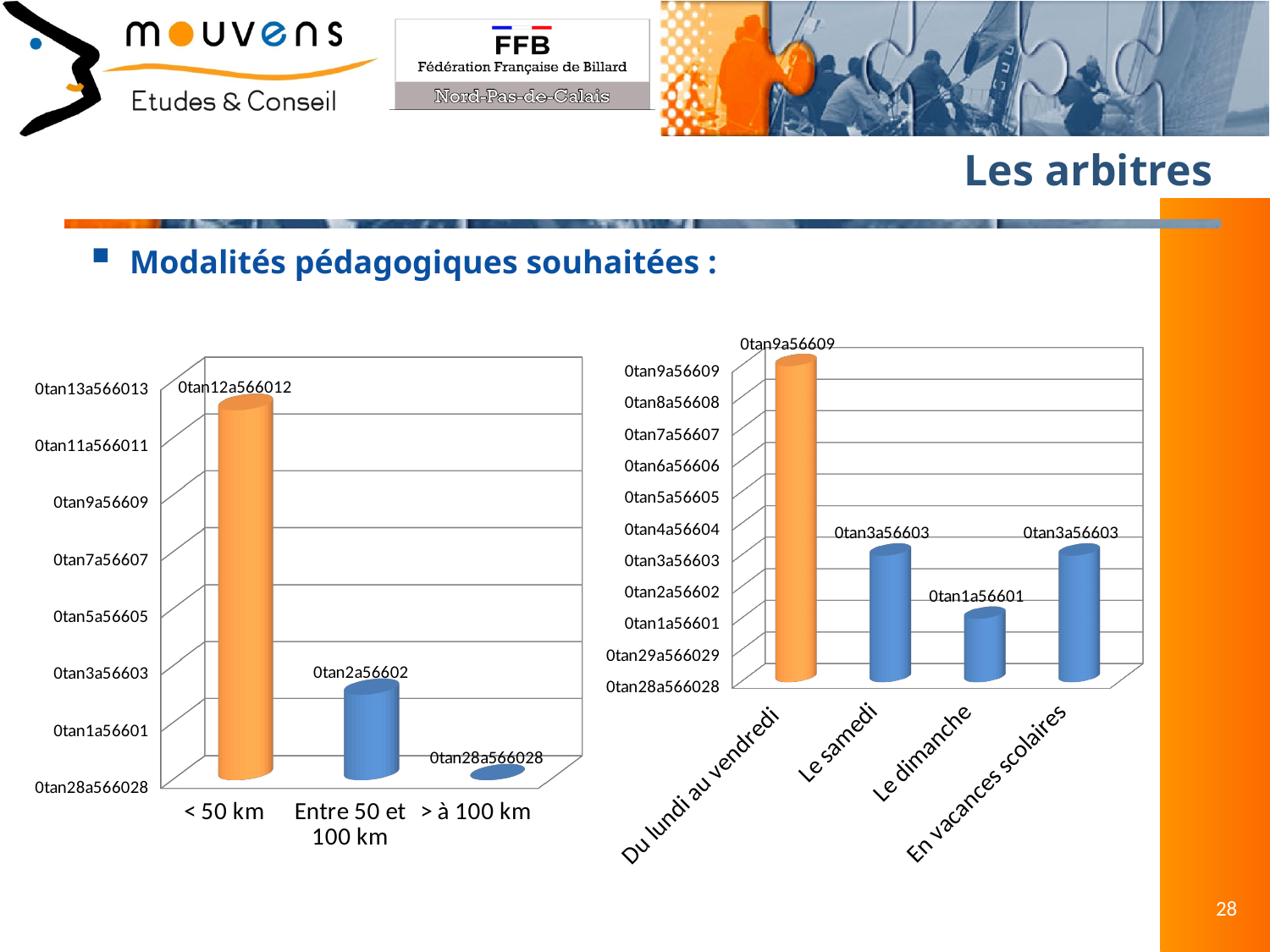
In the left chart, which category has the highest bar? < 50 km How many categories does the right chart show? 4 In the right chart, which is larger: the bar for Le samedi or the bar for Le dimanche? Le samedi In the right chart, what data label is printed above the bar for Le dimanche? 0tan1a56601 In the right chart, which category has the lowest bar? Le dimanche In the right chart, which category has the highest bar? Du lundi au vendredi How many categories does the left chart show? 3 What kind of chart is the left chart on the slide? bar chart In the left chart, which is larger: the bar for < 50 km or the bar for Entre 50 et 100 km? < 50 km In the right chart, what colour is the bar for Du lundi au vendredi? orange In the left chart, which category has the lowest bar? > à 100 km In the left chart, what data label is printed above the bar for Entre 50 et 100 km? 0tan2a56602